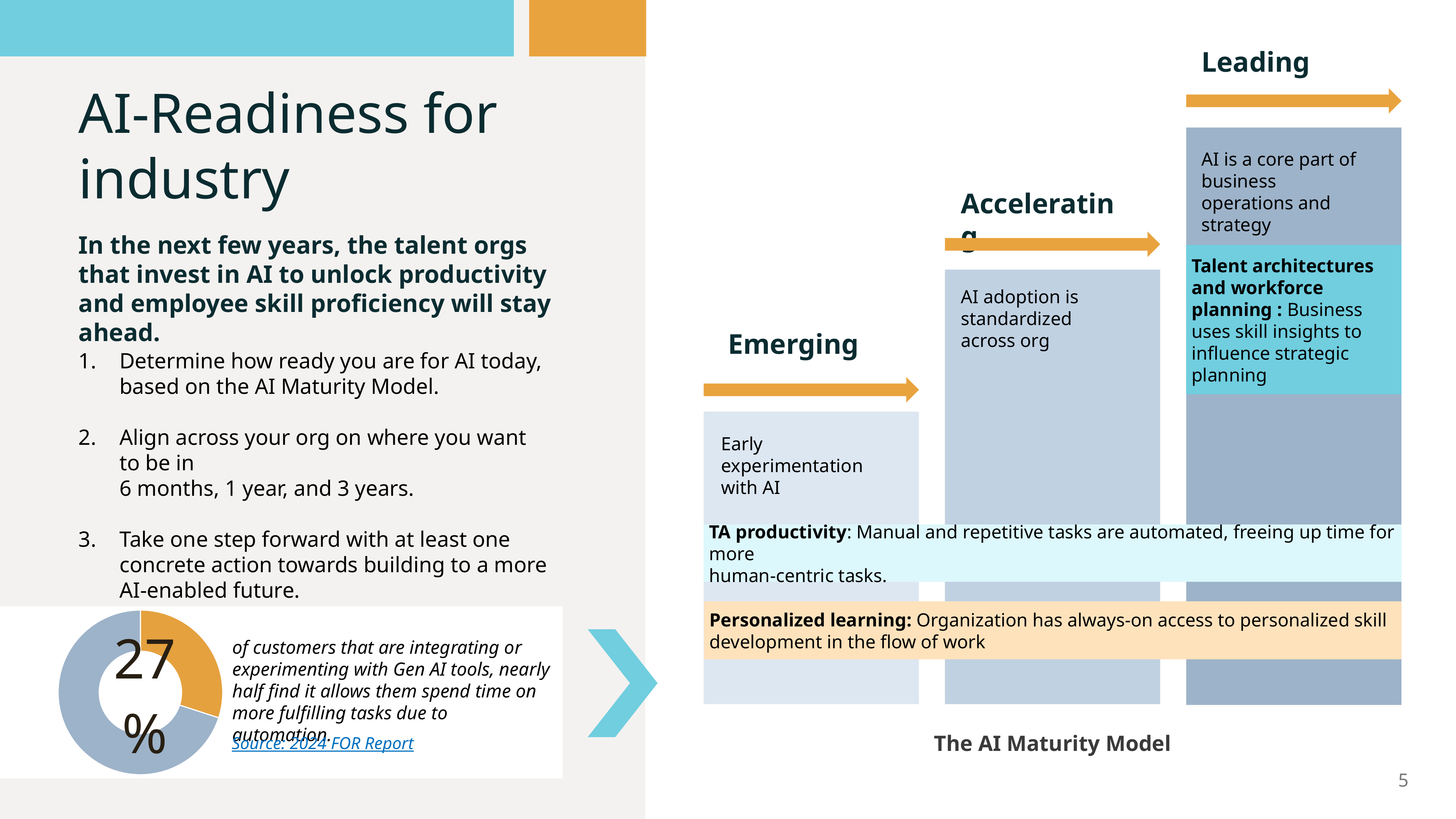
In the doughnut chart, which slice is larger, the orange one or the grey one? The grey one What colour is the slice in the doughnut chart that represents the 27% value? Orange How many slices does the doughnut chart have? 2 Is the value highlighted in the doughnut chart greater or less than 50%? less What kind of chart is shown at the bottom left of the slide? Doughnut chart According to the text next to the doughnut chart, what does the 27% refer to? Customers that are integrating or experimenting with Gen AI tools What percentage is printed in the centre of the doughnut chart? 27%